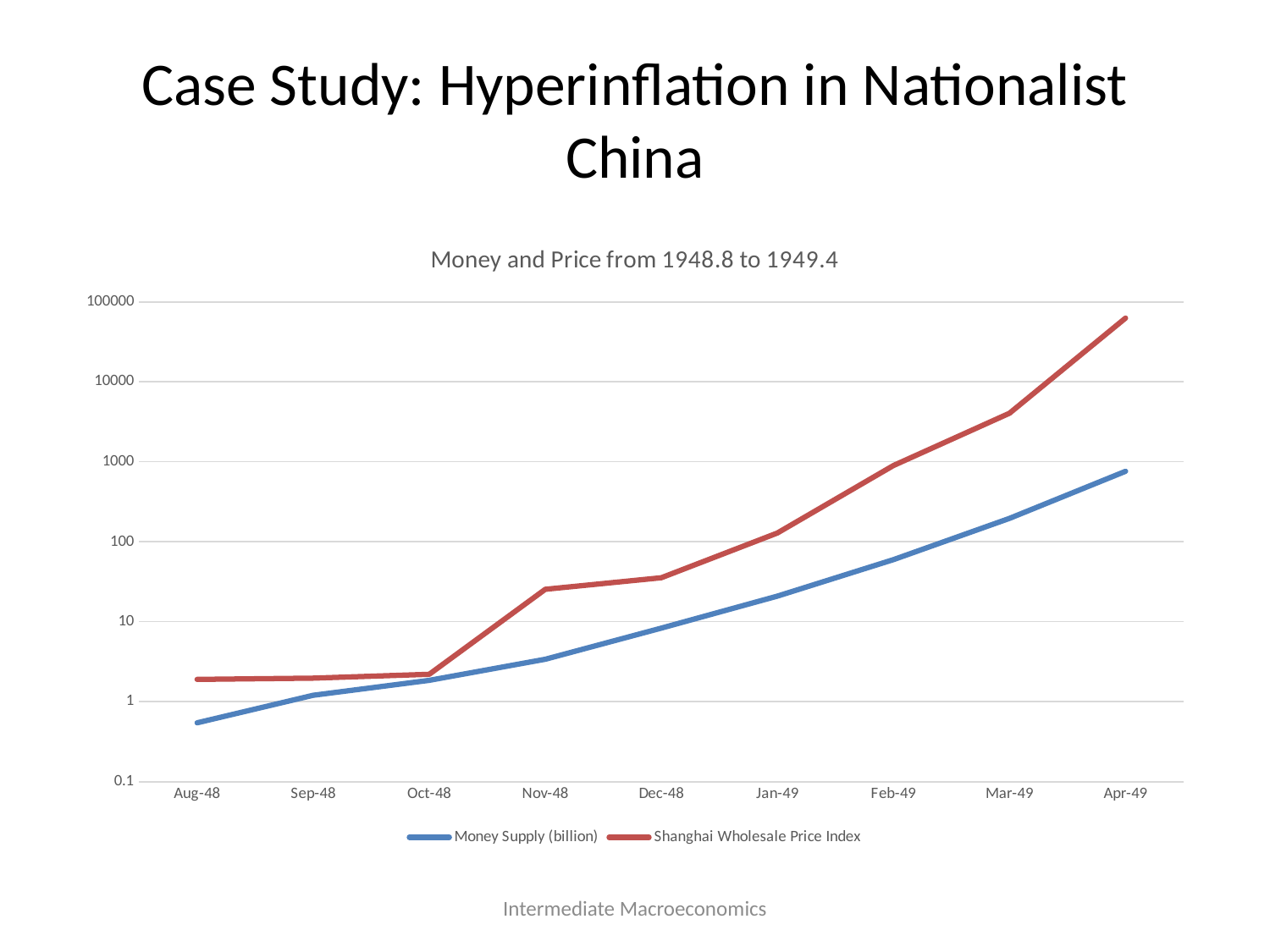
Which colour is used for the Money Supply (billion) line? blue What kind of chart is shown on the slide? line chart How many series does the legend list? 2 What is the title of the chart? Money and Price from 1948.8 to 1949.4 In which month is the Shanghai Wholesale Price Index highest? Apr-49 In Apr-49, which is larger: the Money Supply (billion) or the Shanghai Wholesale Price Index? Shanghai Wholesale Price Index Do the values of the Shanghai Wholesale Price Index rise or fall from Aug-48 to Apr-49? rise In which month is the Money Supply (billion) lowest? Aug-48 Is the value for Money Supply (billion) in Apr-49 greater or less than 1000? less How many months are plotted along the x axis? 9 Is the value for Money Supply (billion) in Aug-48 greater or less than 1? less Is the value for the Shanghai Wholesale Price Index in Apr-49 greater or less than 10000? greater